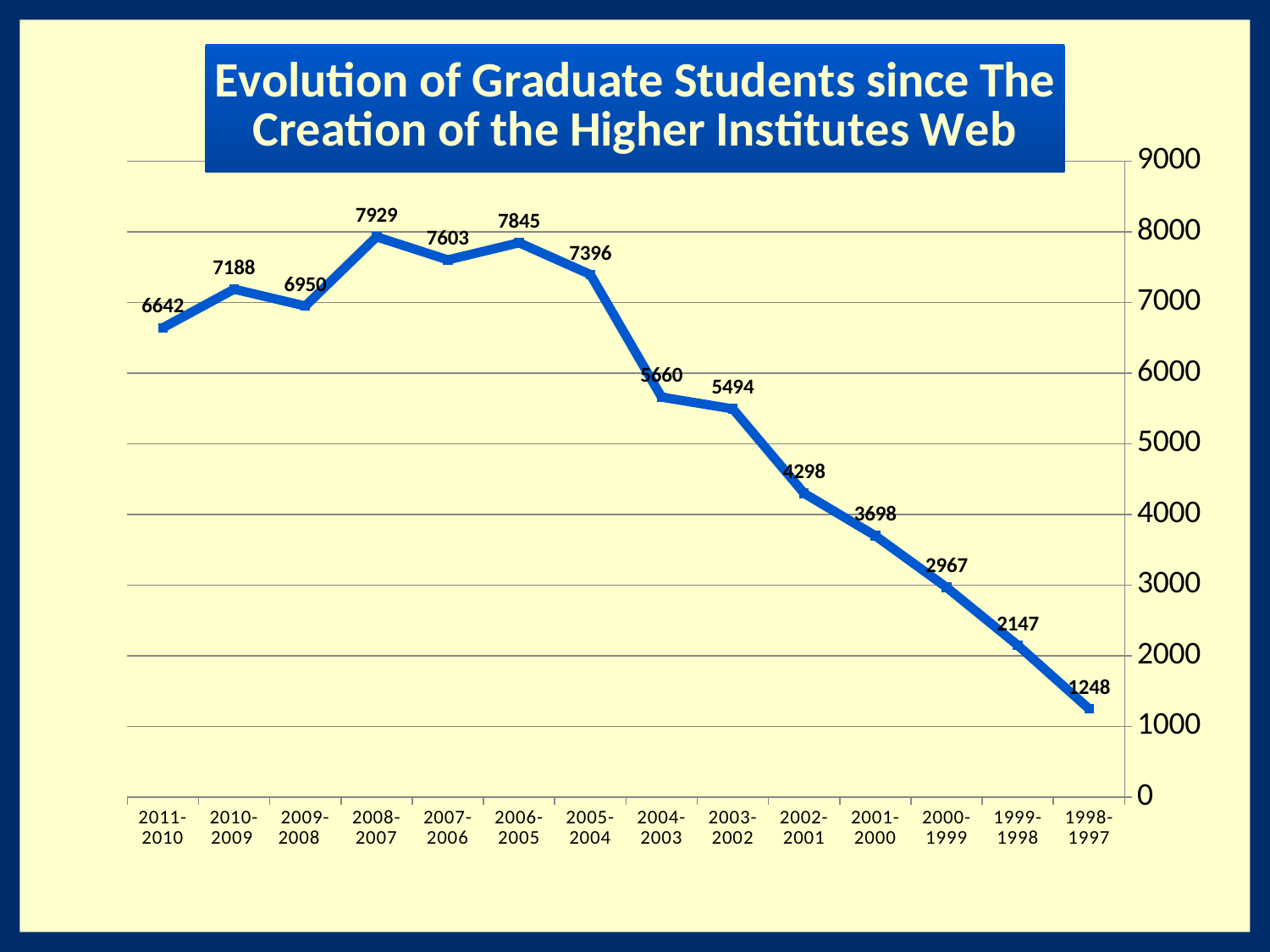
Do the values generally rise or fall moving from left to right along the x axis? fall Which academic year has the lowest value? 1998-1997 What is the difference between the values for 2002-2001 and 2001-2000? 600 What type of chart is shown on the slide? line chart What is the value for 2004-2003? 5660 Which is larger, the value for 2006-2005 or the value for 2007-2006? 2006-2005 What is the title of the chart? Evolution of Graduate Students since The Creation of the Higher Institutes Web What is the value for 1998-1997? 1248 What is the difference between the values for 2008-2007 and 1998-1997? 6681 Which academic year has the highest value? 2008-2007 How many academic years are plotted on the x axis? 14 What is the value for 2008-2007? 7929